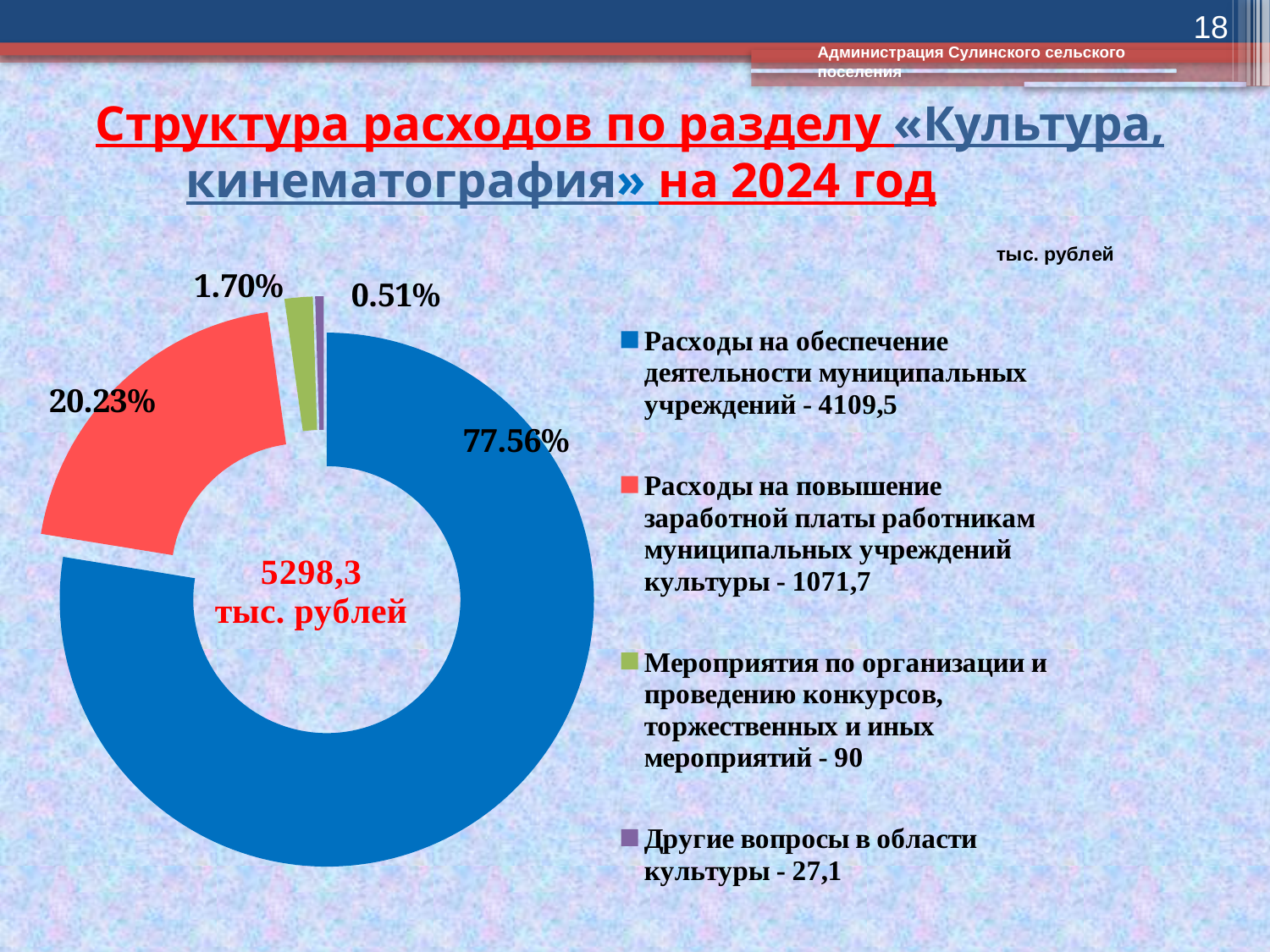
What total amount is shown in the centre of the chart? 5298,3 тыс. рублей Which category has the smallest share of the chart? Другие вопросы в области культуры What share of the chart does "Расходы на повышение заработной платы работникам муниципальных учреждений культуры" take? 20.23% Which category has the largest share of the chart? Расходы на обеспечение деятельности муниципальных учреждений What share of the chart does "Мероприятия по организации и проведению конкурсов, торжественных и иных мероприятий" take? 1.70% How many categories does the legend list? 4 What is the value for "Другие вопросы в области культуры" in тыс. рублей? 27,1 What kind of chart is shown on the slide? doughnut chart What share of the chart does "Расходы на обеспечение деятельности муниципальных учреждений" take? 77.56% What is the value for "Расходы на обеспечение деятельности муниципальных учреждений" in тыс. рублей? 4109,5 What is the difference in тыс. рублей between "Расходы на обеспечение деятельности муниципальных учреждений" and "Расходы на повышение заработной платы работникам муниципальных учреждений культуры"? 3037,8